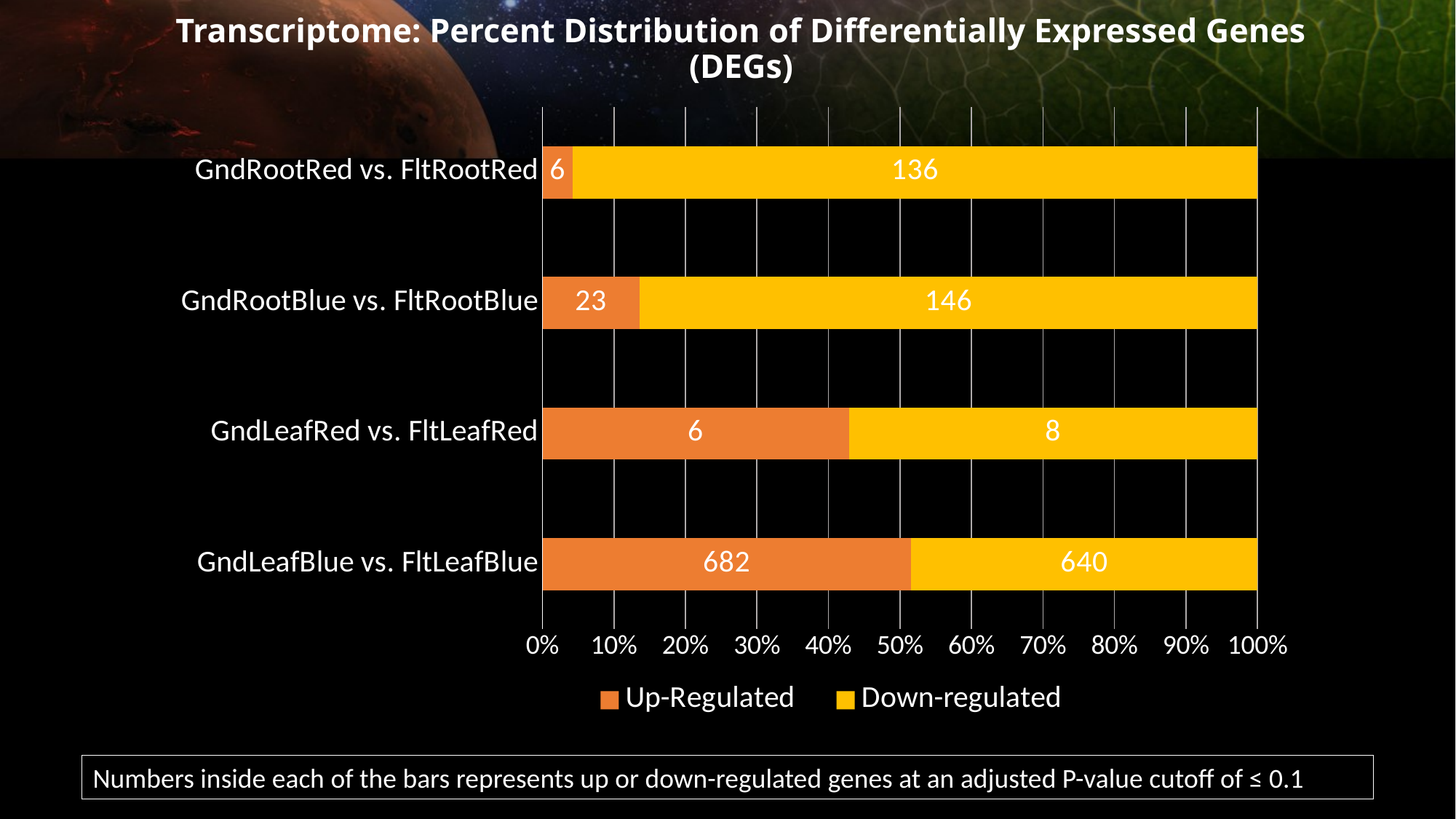
What type of chart is shown on the slide? Stacked bar chart What is the Down-regulated value labelled for GndRootBlue vs. FltRootBlue? 146 What is the Up-Regulated value labelled for GndLeafBlue vs. FltLeafBlue? 682 How many series does the legend list? 2 What is the total of the Up-Regulated and Down-regulated values for GndRootBlue vs. FltRootBlue? 169 Which series is shown in orange according to the legend? Up-Regulated Is the Up-Regulated share of the bar for GndLeafRed vs. FltLeafRed greater or less than 50%? less Which category has the highest Up-Regulated value? GndLeafBlue vs. FltLeafBlue Which category has the lowest Down-regulated value? GndLeafRed vs. FltLeafRed What is the Down-regulated value labelled for GndLeafRed vs. FltLeafRed? 8 What is the difference between the Up-Regulated and Down-regulated values for GndLeafBlue vs. FltLeafBlue? 42 How many comparison categories are plotted on the chart? 4